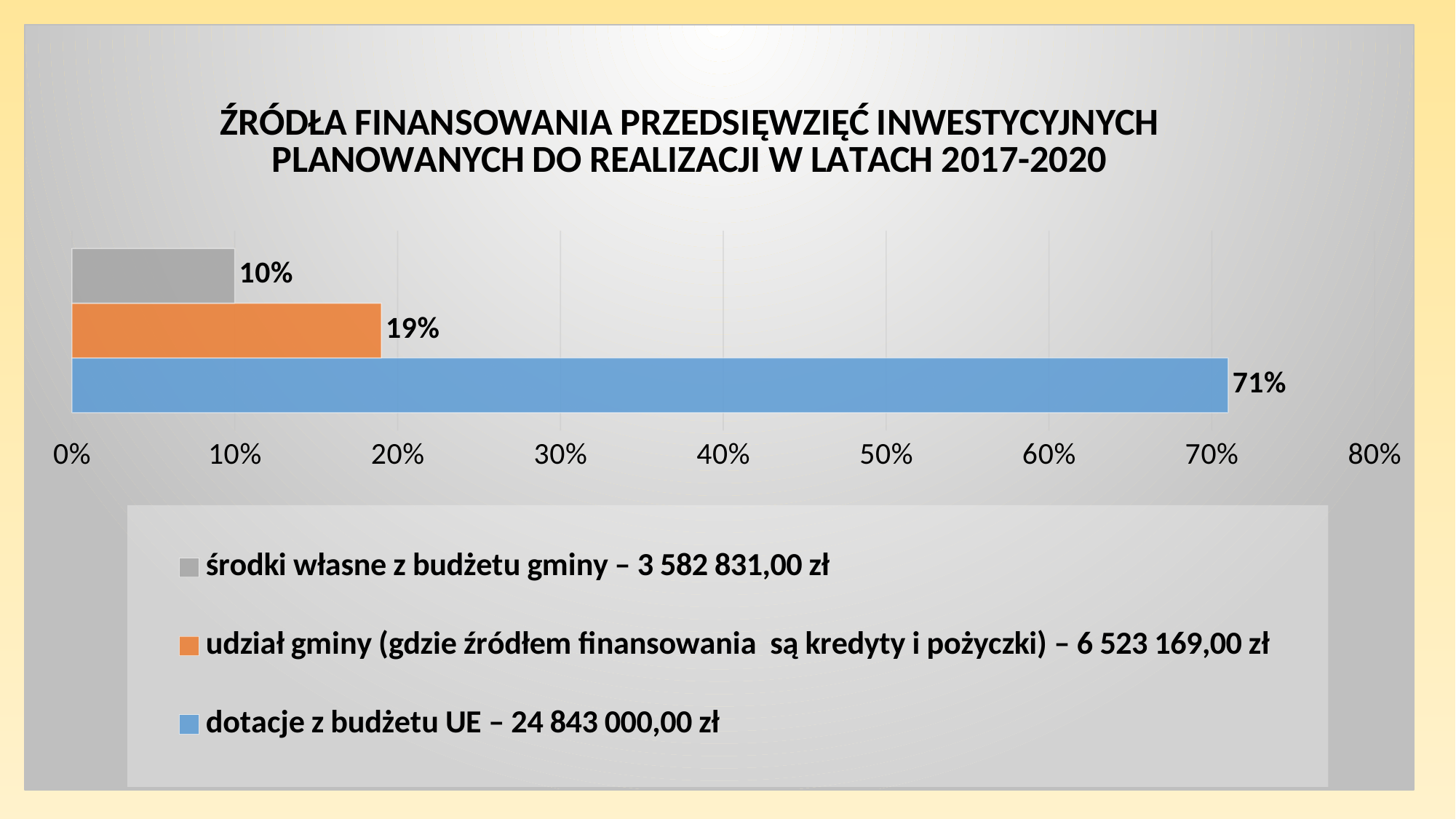
What is the difference in percentage points between dotacje z budżetu UE and udział gminy? 52% Which funding source has the lowest share? środki własne z budżetu gminy What percentage share is shown for udział gminy (gdzie źródłem finansowania są kredyty i pożyczki)? 19% What amount in zł is listed in the legend for dotacje z budżetu UE? 24 843 000,00 zł Is the value for dotacje z budżetu UE greater or less than 60%? greater How many funding sources are plotted in the chart? 3 What percentage share is shown for środki własne z budżetu gminy? 10% What type of chart is shown on the slide? bar chart What is the difference in percentage points between udział gminy and środki własne z budżetu gminy? 9% Which is larger: the share for udział gminy or the share for środki własne z budżetu gminy? udział gminy What percentage share is shown for dotacje z budżetu UE? 71% Which funding source has the highest share? dotacje z budżetu UE